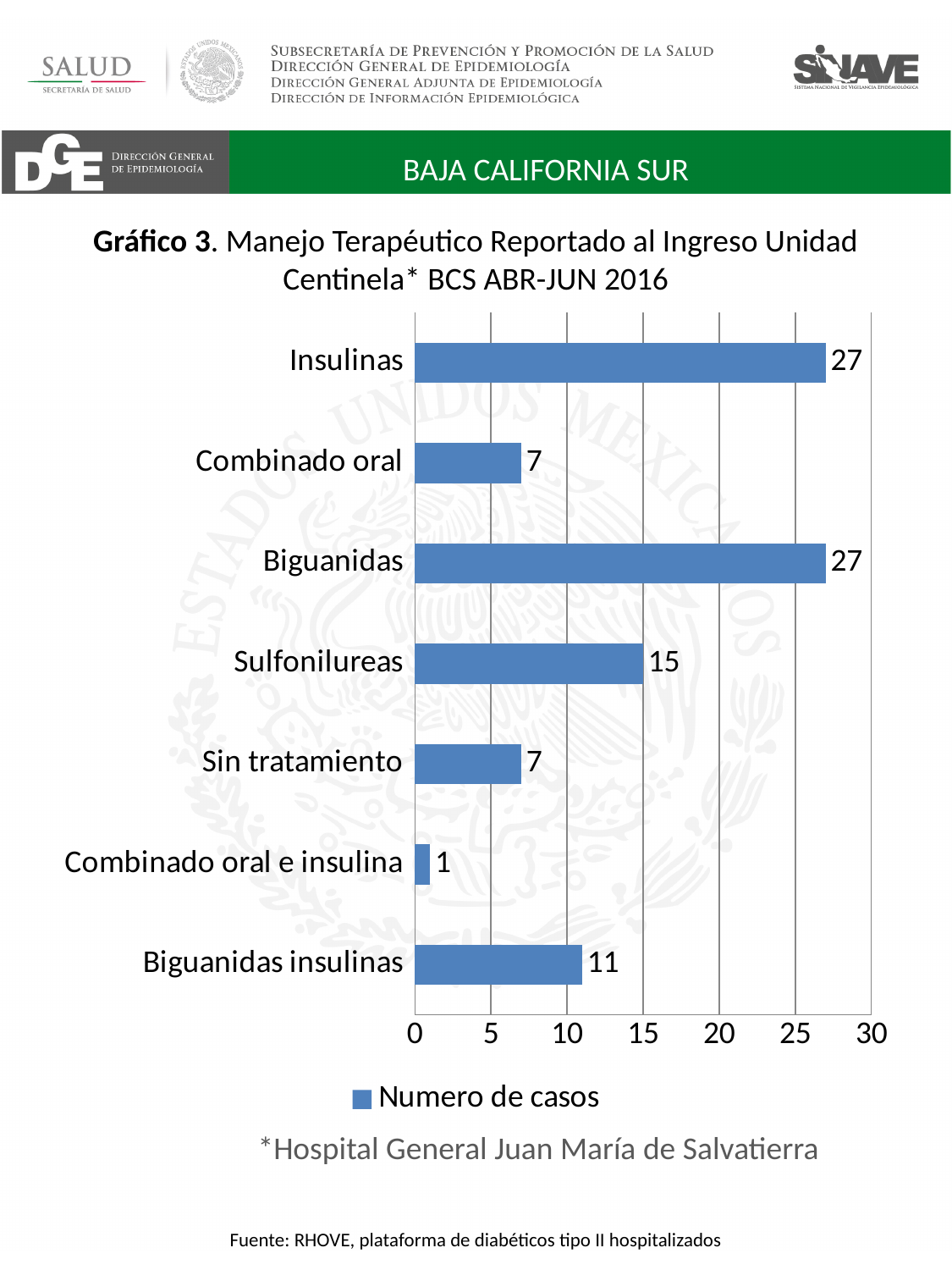
What is the legend entry for the series? Numero de casos How many series does the legend list? 1 Which category has the lowest value? Combinado oral e insulina What is the value for Sulfonilureas? 15 Is the value for Biguanidas greater or less than 25? greater What is the value for Insulinas? 27 What is the difference between the values for Sulfonilureas and Combinado oral? 8 What is the difference between the values for Insulinas and Biguanidas insulinas? 16 How many categories are shown on the chart? 7 What kind of chart is shown? Bar chart What is the value for Biguanidas insulinas? 11 Which is larger, the value for Sulfonilureas or the value for Biguanidas insulinas? Sulfonilureas